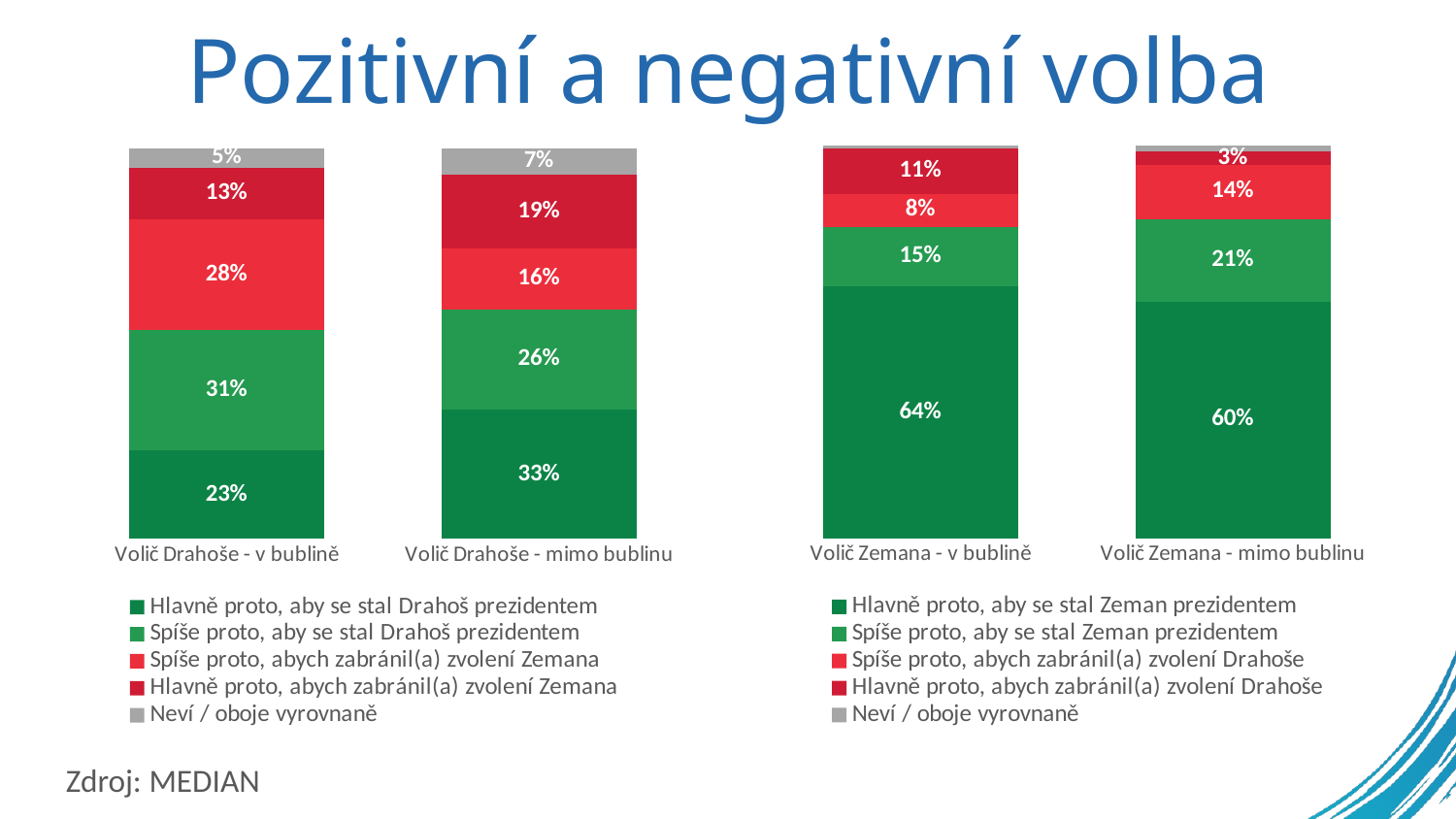
In the left chart (Drahoš voters), what percentage of 'Volič Drahoše - v bublině' chose 'Hlavně proto, aby se stal Drahoš prezidentem'? 23% In the right chart (Zeman voters), which category has the larger value for 'Spíše proto, aby se stal Zeman prezidentem': 'Volič Zemana - v bublině' or 'Volič Zemana - mimo bublinu'? Volič Zemana - mimo bublinu In the left chart (Drahoš voters), which segment is the smallest for 'Volič Drahoše - mimo bublinu'? Neví / oboje vyrovnaně In the right chart (Zeman voters), what is the difference between the 'Spíše proto, abych zabránil(a) zvolení Drahoše' values for 'Volič Zemana - mimo bublinu' and 'Volič Zemana - v bublině'? 6 percentage points In the left chart (Drahoš voters), what is the value of 'Spíše proto, aby se stal Drahoš prezidentem' for 'Volič Drahoše - mimo bublinu'? 26% How many categories (bars) does the left chart (Drahoš voters) show? 2 How many series does the legend of the right chart (Zeman voters) list? 5 What kind of chart is the right chart (Zeman voters)? Stacked bar chart In the right chart (Zeman voters), what is the value of 'Hlavně proto, abych zabránil(a) zvolení Drahoše' for 'Volič Zemana - mimo bublinu'? 3% In the right chart (Zeman voters), what percentage of 'Volič Zemana - v bublině' chose 'Hlavně proto, aby se stal Zeman prezidentem'? 64% In the left chart (Drahoš voters), what is the difference between the 'Hlavně proto, aby se stal Drahoš prezidentem' values for 'Volič Drahoše - mimo bublinu' and 'Volič Drahoše - v bublině'? 10 percentage points In the left chart (Drahoš voters), which segment is the largest for 'Volič Drahoše - v bublině'? Spíše proto, aby se stal Drahoš prezidentem